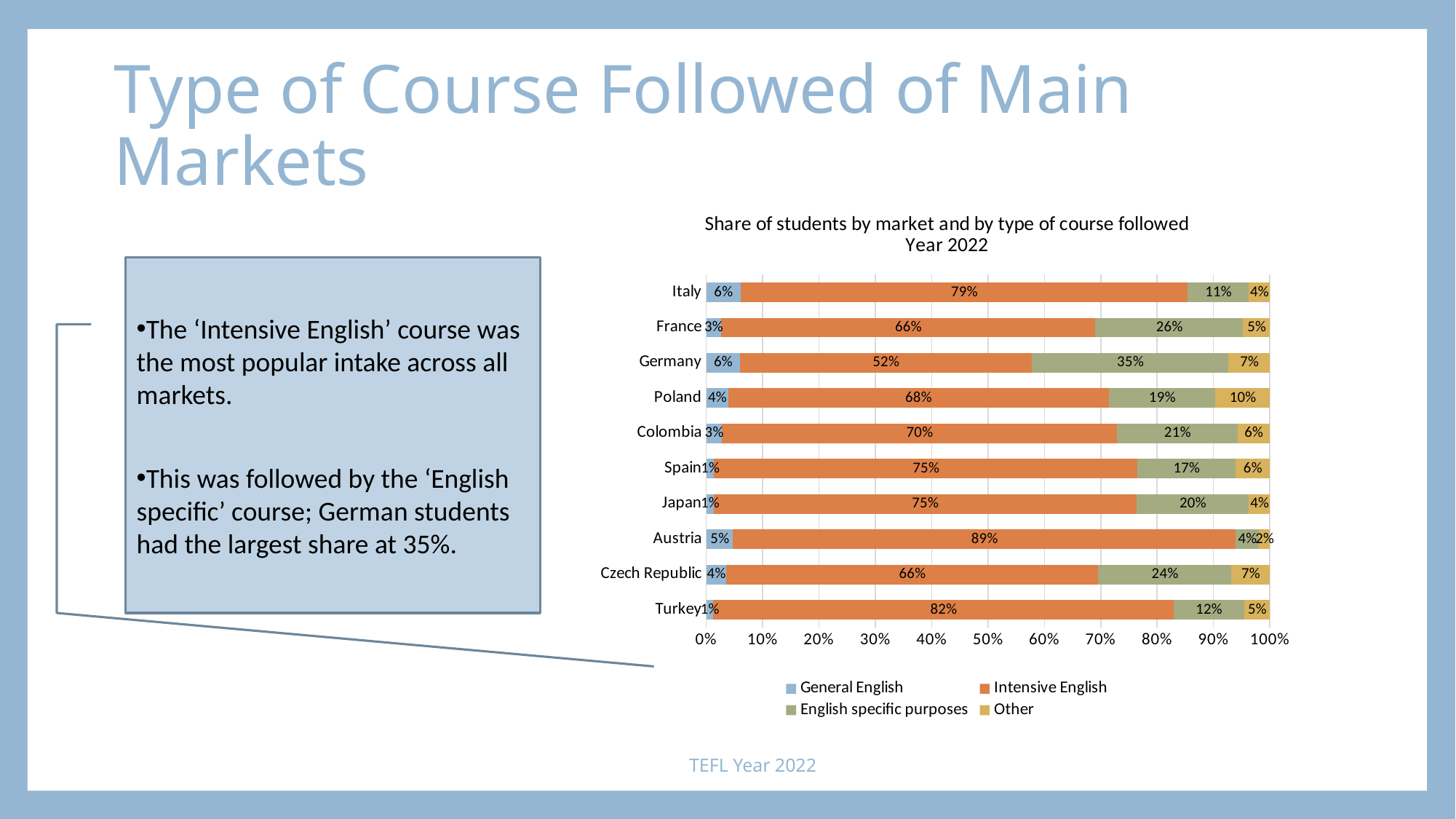
What is the difference between the Intensive English shares of Austria and Germany? 37% Which market has the highest Intensive English share? Austria What is the Other share for Poland? 10% How many markets are shown on the chart? 10 What is the total of the stacked bar for Italy? 100% What kind of chart is shown on the slide? Bar chart Which is larger, the English specific purposes share for France or for Czech Republic? France What is the Intensive English share for Italy? 79% What is the title of the chart? Share of students by market and by type of course followed Year 2022 How many series does the legend list? 4 What is the English specific purposes share for Germany? 35% Which market has the lowest Intensive English share? Germany